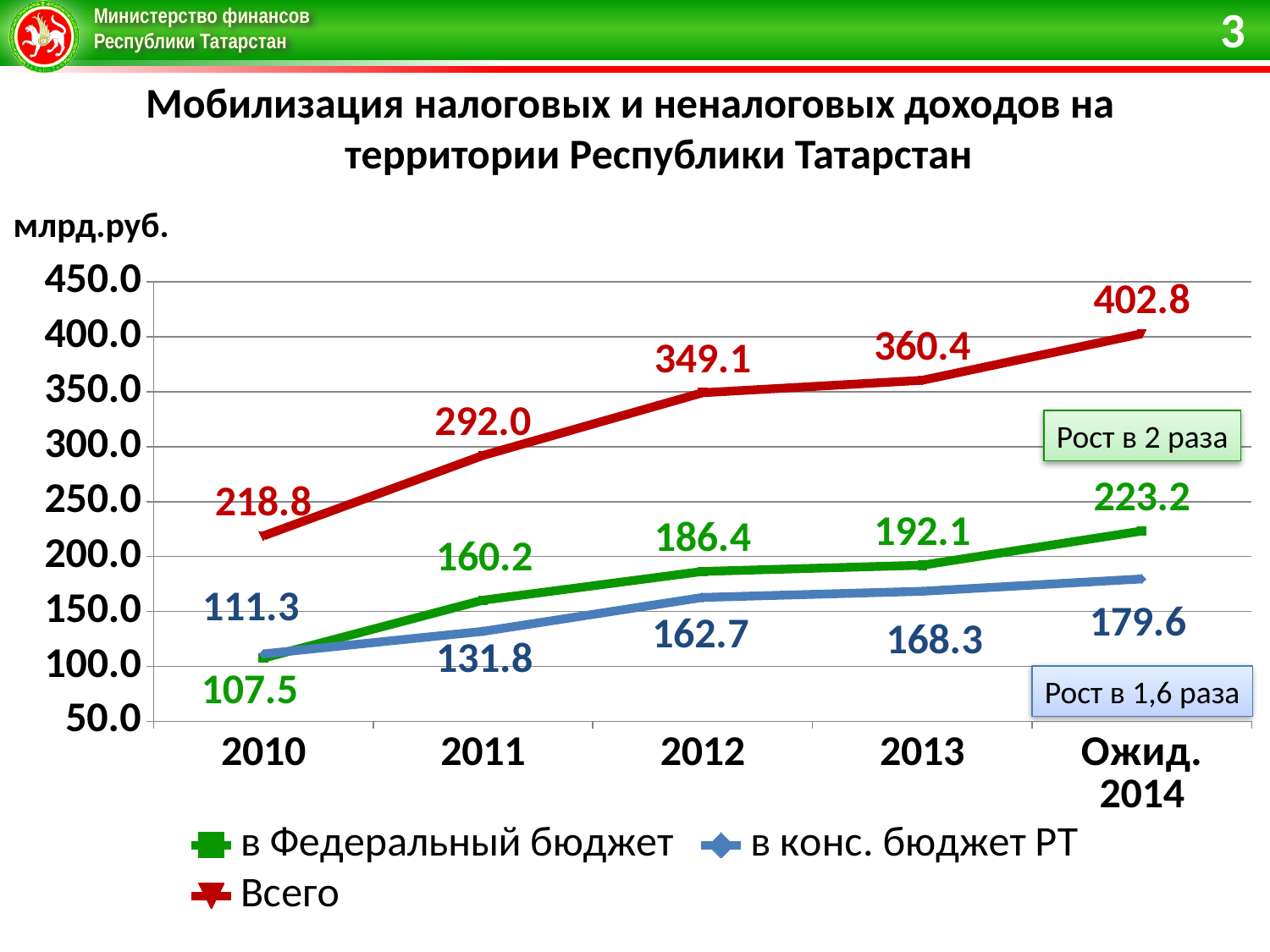
What is the value for в Федеральный бюджет in 2011? 160.2 What unit is shown above the chart? млрд.руб. What type of chart is shown on the slide? line chart How many series does the legend list? 3 What is the value for Всего in 2012? 349.1 Does the value for Всего rise or fall from 2010 to Ожид. 2014? rise What is the difference between the Всего values for Ожид. 2014 and 2010? 184.0 In which year is the value for в Федеральный бюджет the highest? Ожид. 2014 Which is larger in 2013: в Федеральный бюджет or в конс. бюджет РТ? в Федеральный бюджет What is the value for в конс. бюджет РТ in Ожид. 2014? 179.6 How many points are plotted along the x axis for each series? 5 In which year is the value for Всего the lowest? 2010